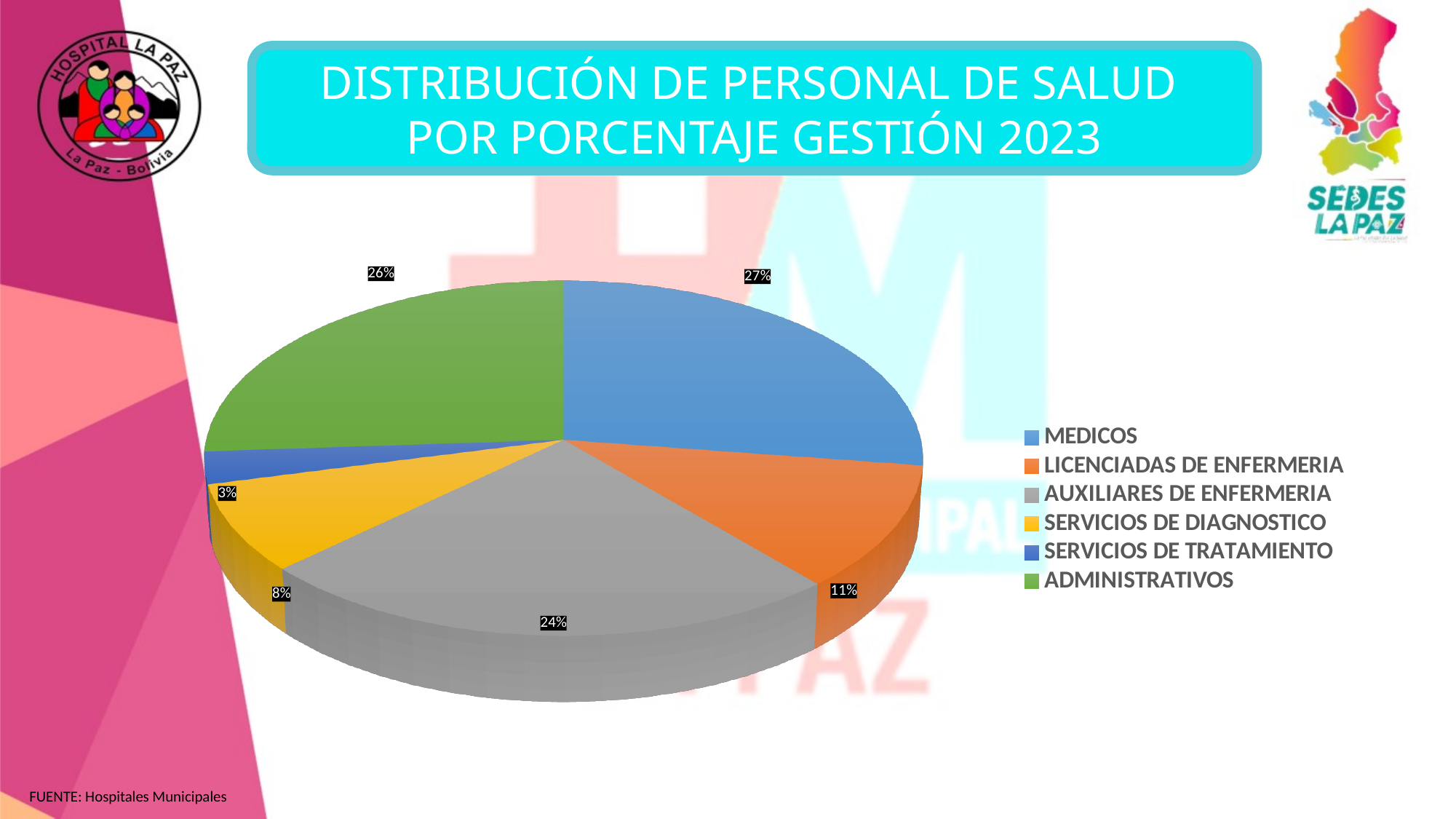
Which category has the largest share of the pie? MEDICOS What percentage is shown for LICENCIADAS DE ENFERMERIA? 11% Which is larger, the share for LICENCIADAS DE ENFERMERIA or the share for SERVICIOS DE DIAGNOSTICO? LICENCIADAS DE ENFERMERIA What share of the pie corresponds to AUXILIARES DE ENFERMERIA? 24% What percentage of the health personnel are MEDICOS? 27% What is the difference in percentage points between AUXILIARES DE ENFERMERIA and SERVICIOS DE DIAGNOSTICO? 16 Which category has the smallest share of the pie? SERVICIOS DE TRATAMIENTO How many categories does the legend of the pie chart list? 6 What colour represents ADMINISTRATIVOS in the pie chart? green What kind of chart is shown on the slide? pie chart What percentage is shown for ADMINISTRATIVOS? 26% What percentage is shown for SERVICIOS DE TRATAMIENTO? 3%